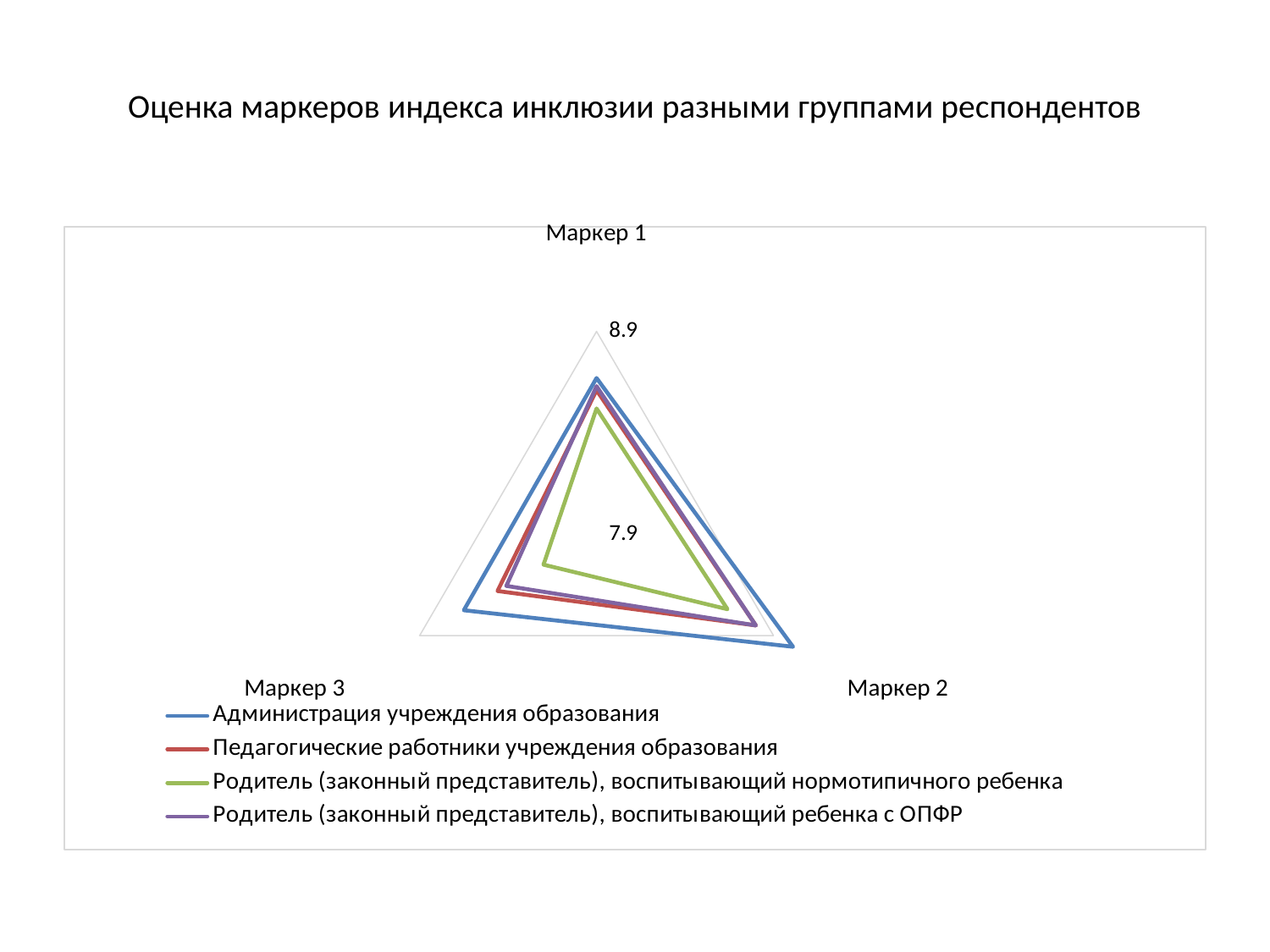
What kind of chart is shown on the slide? Radar chart Which group of respondents gives the highest rating on Маркер 3? Администрация учреждения образования Which group of respondents gives the lowest rating on Маркер 1? Родитель (законный представитель), воспитывающий нормотипичного ребенка Is the rating by Администрация учреждения образования on Маркер 1 greater or less than 8.9? less Which group of respondents gives the lowest rating on Маркер 2? Родитель (законный представитель), воспитывающий нормотипичного ребенка Which colour is used for the series Педагогические работники учреждения образования? Red On Маркер 2, which is larger: the rating by Администрация учреждения образования or by Родитель (законный представитель), воспитывающий нормотипичного ребенка? Администрация учреждения образования Which group of respondents gives the highest rating on Маркер 1? Администрация учреждения образования How many markers (axes) does the radar chart have? 3 How many series does the legend list? 4 What is the title of the chart on the slide? Оценка маркеров индекса инклюзии разными группами респондентов Is the rating by Родитель (законный представитель), воспитывающий нормотипичного ребенка on Маркер 3 greater or less than 7.9? greater